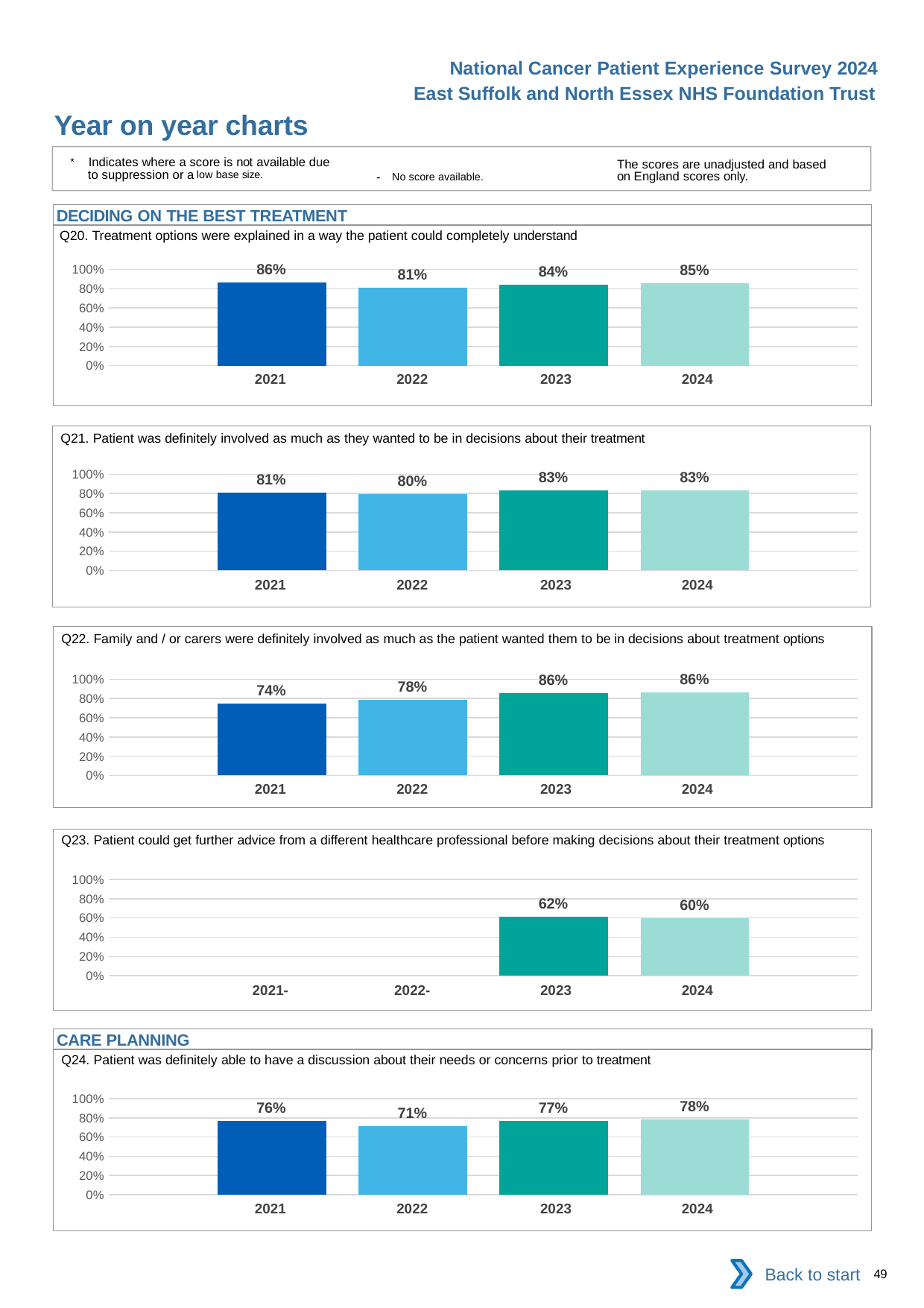
In the Q24 chart, what is the difference between the 2021 and 2022 values? 5% In the Q20 chart, what is the value for 2021? 86% What kind of chart is the Q21 chart? bar chart In the Q24 chart, which year has the highest value? 2024 In the Q21 chart, what is the difference between the 2023 and 2022 values? 3% In the Q23 chart, what is the value for 2024? 60% In the Q22 chart, which year has the lowest value? 2021 In the Q20 chart, is the value for 2023 greater or less than 80%? greater In the Q20 chart, which year has the lowest value? 2022 In the Q22 chart, do the values rise or fall from 2021 to 2024? rise In the Q23 chart, how many years have a bar plotted? 2 In the Q24 chart, is the value for 2022 larger or smaller than the value for 2021? smaller